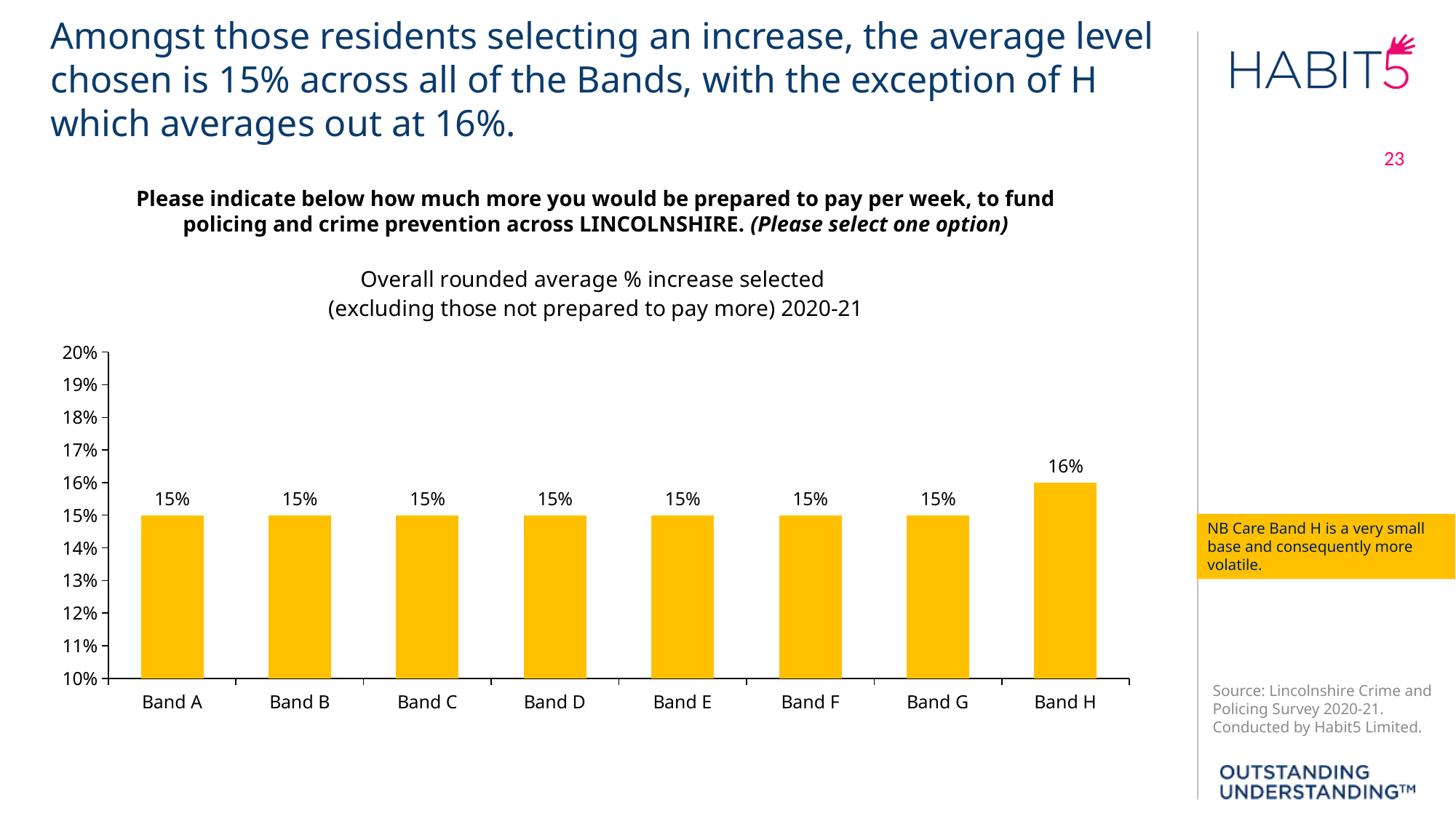
What kind of chart is shown on the slide? Bar chart Is the value for Band H greater or less than 15%? greater How many bands have a value of 15%? 7 What is the difference between the values for Band H and Band G? 1% What is the title of the chart? Overall rounded average % increase selected (excluding those not prepared to pay more) 2020-21 Which is larger, the value for Band H or the value for Band C? Band H What is the value for Band H? 16% Is the value for Band B greater or less than 18%? less What is the value for Band D? 15% What is the value for Band A? 15% How many bands are shown on the chart? 8 Which band has the highest value? Band H